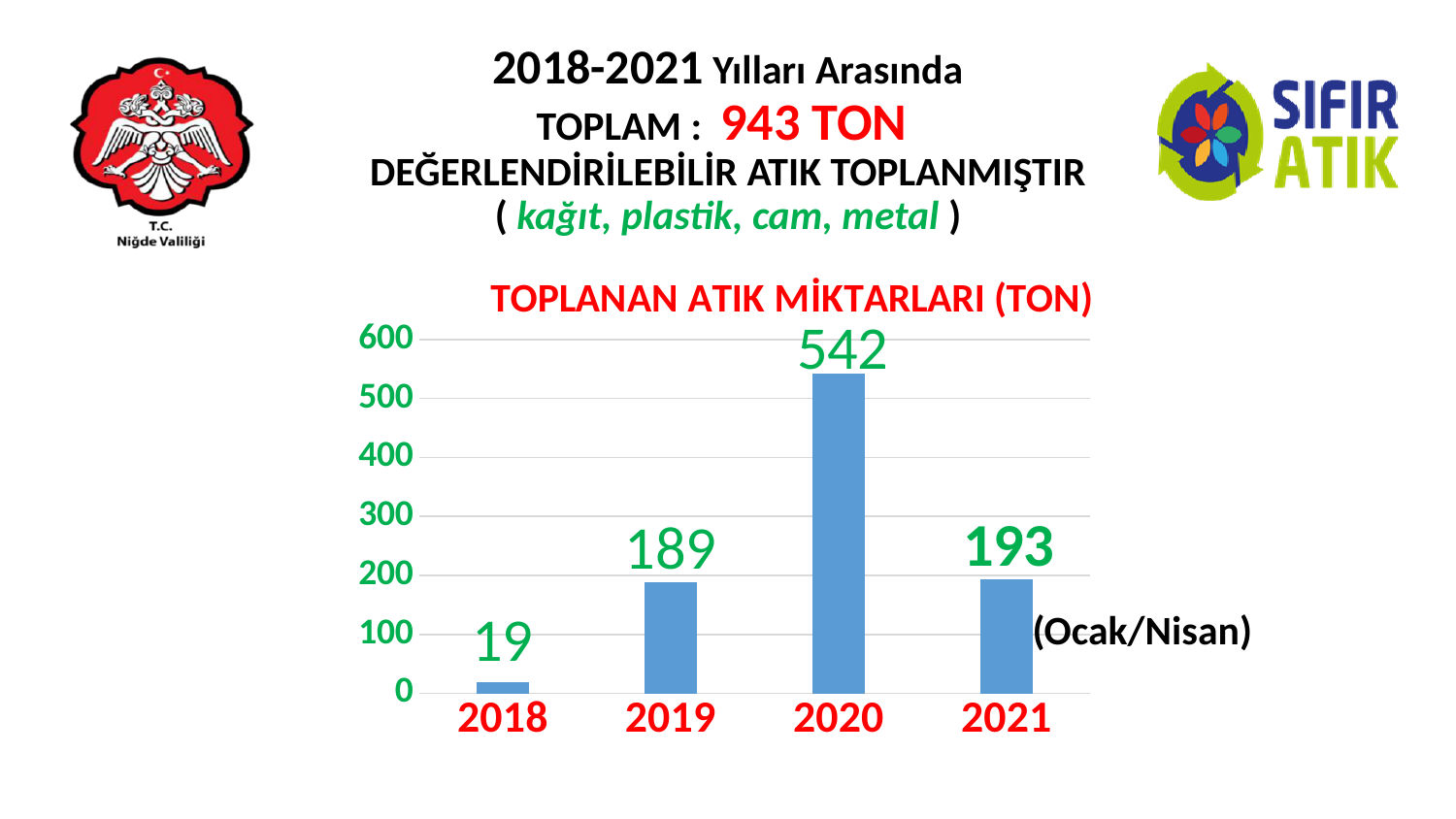
Which year has the highest value? 2020 What is the difference between the values for 2020 and 2019? 353 What is the value for 2021? 193 Which is larger, the value for 2020 or the value for 2021? 2020 Which year has the lowest value? 2018 What is the value for 2018? 19 What is the title of the chart? TOPLANAN ATIK MİKTARLARI (TON) How many years are shown on the x axis? 4 What is the value for 2019? 189 What is the difference between the values for 2021 and 2018? 174 What is the value for 2020? 542 What kind of chart is this? bar chart